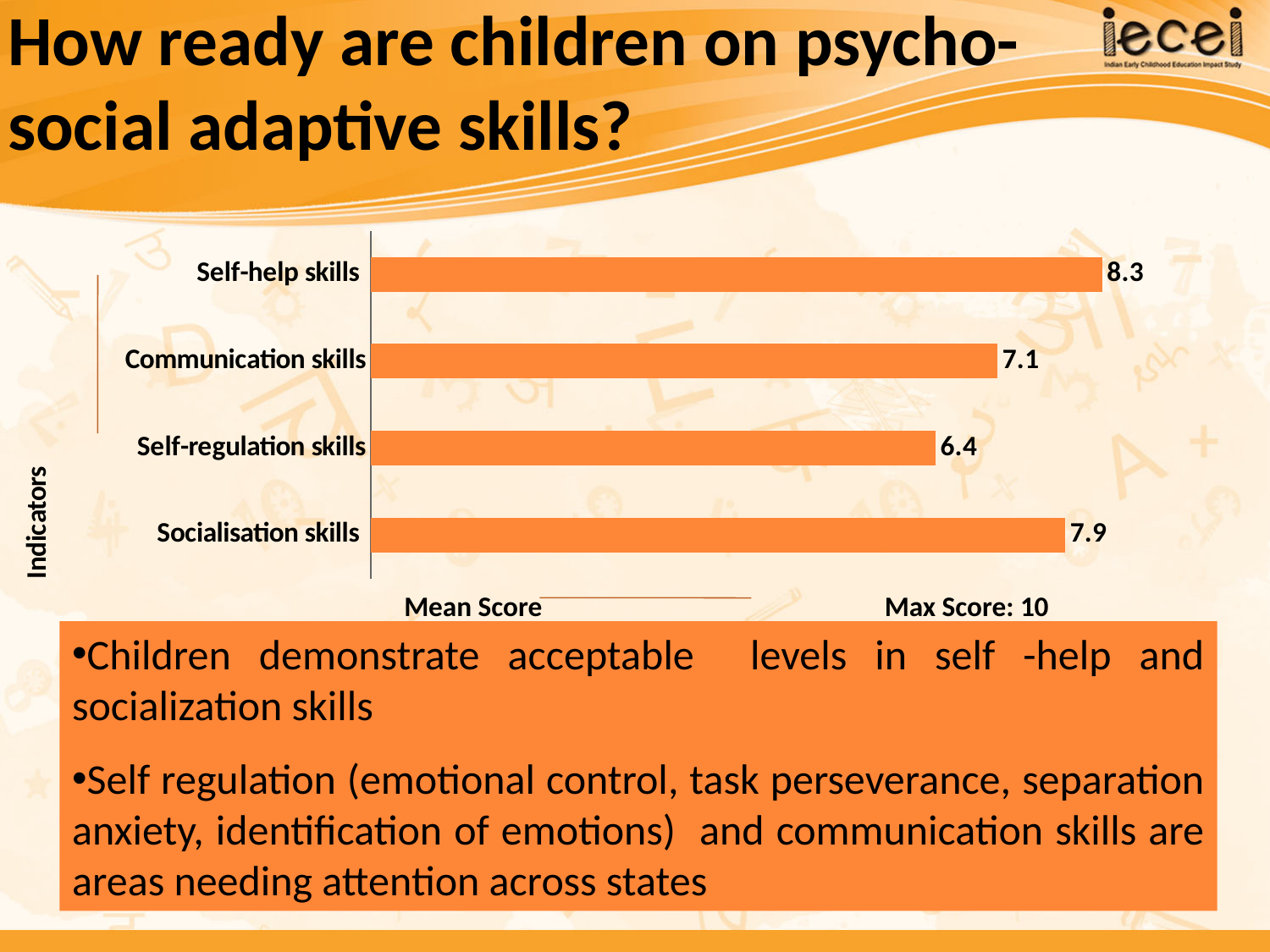
Which has a higher mean score, Communication skills or Socialisation skills? Socialisation skills Which indicator has the lowest mean score? Self-regulation skills Which indicator has the highest mean score? Self-help skills What type of chart is shown on the slide? Bar chart What is the mean score for Self-help skills? 8.3 What is the mean score for Communication skills? 7.1 What is the mean score for Socialisation skills? 7.9 What is the maximum possible score noted below the chart? 10 What is the difference between the mean scores for Socialisation skills and Communication skills? 0.8 What is the mean score for Self-regulation skills? 6.4 How many indicators are shown in the chart? 4 What is the difference between the mean scores for Self-help skills and Self-regulation skills? 1.9